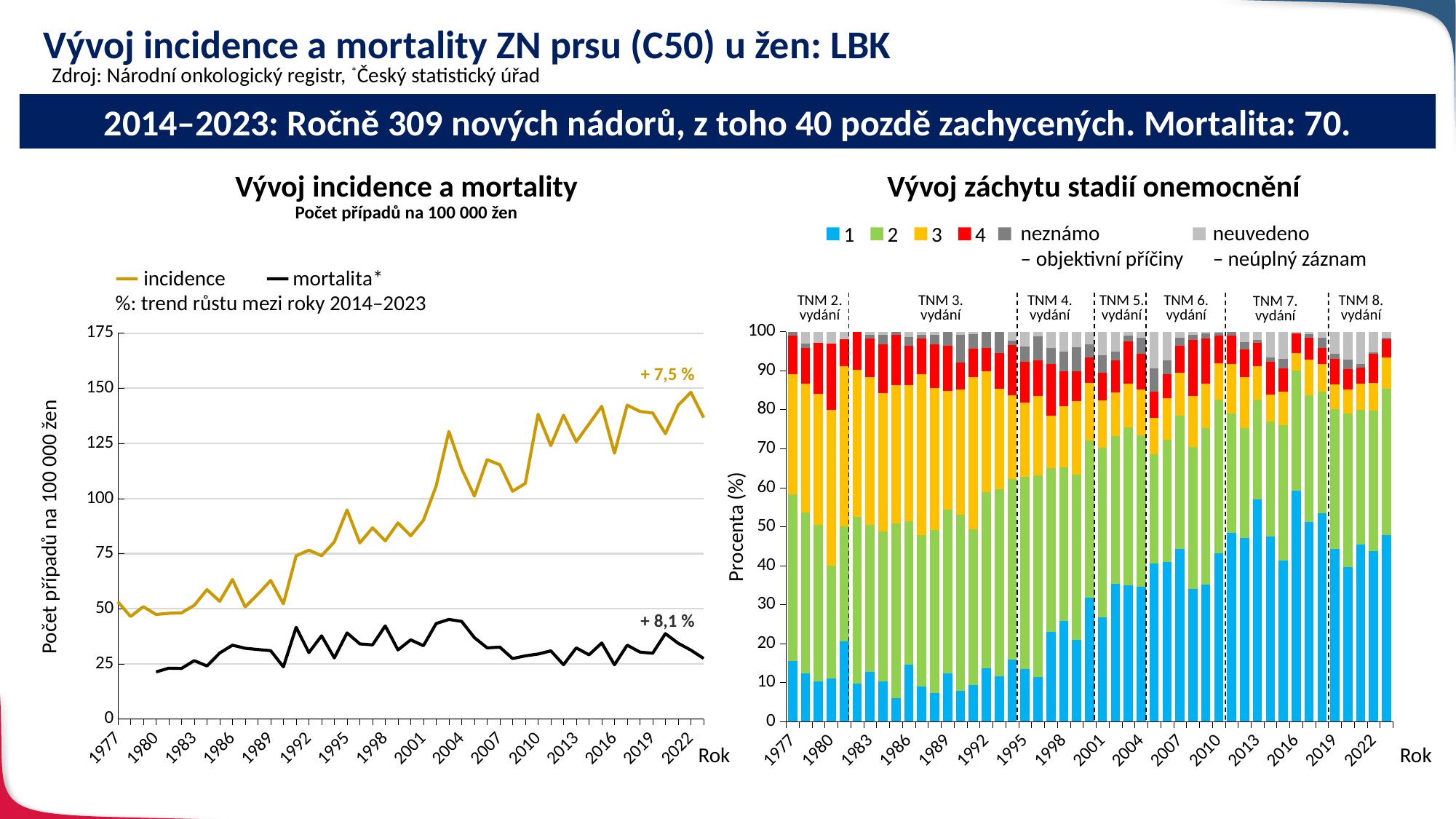
In the left chart 'Vývoj incidence a mortality', does the incidence line generally rise or fall from 1977 to 2022? rise In the right chart 'Vývoj záchytu stadií onemocnění', how many series does the legend list? 6 In the left chart 'Vývoj incidence a mortality', which series has the higher value in 2010, incidence or mortalita? incidence In the left chart 'Vývoj incidence a mortality', is the incidence value for 2022 greater or less than 125? greater In the right chart 'Vývoj záchytu stadií onemocnění', is the share of stage 1 in 1977 greater or less than 20%? less What kind of chart is the left chart titled 'Vývoj incidence a mortality'? line chart What kind of chart is the right chart titled 'Vývoj záchytu stadií onemocnění'? stacked bar chart In the left chart 'Vývoj incidence a mortality', is the mortalita value for 2022 greater or less than 50? less In the left chart 'Vývoj incidence a mortality', what growth trend percentage is printed for the incidence line? + 7,5 % In the left chart 'Vývoj incidence a mortality', how many series does the legend list? 2 In the right chart 'Vývoj záchytu stadií onemocnění', what is the label of the y axis? Procenta (%) In the left chart 'Vývoj incidence a mortality', what growth trend percentage is printed for the mortalita line? + 8,1 %